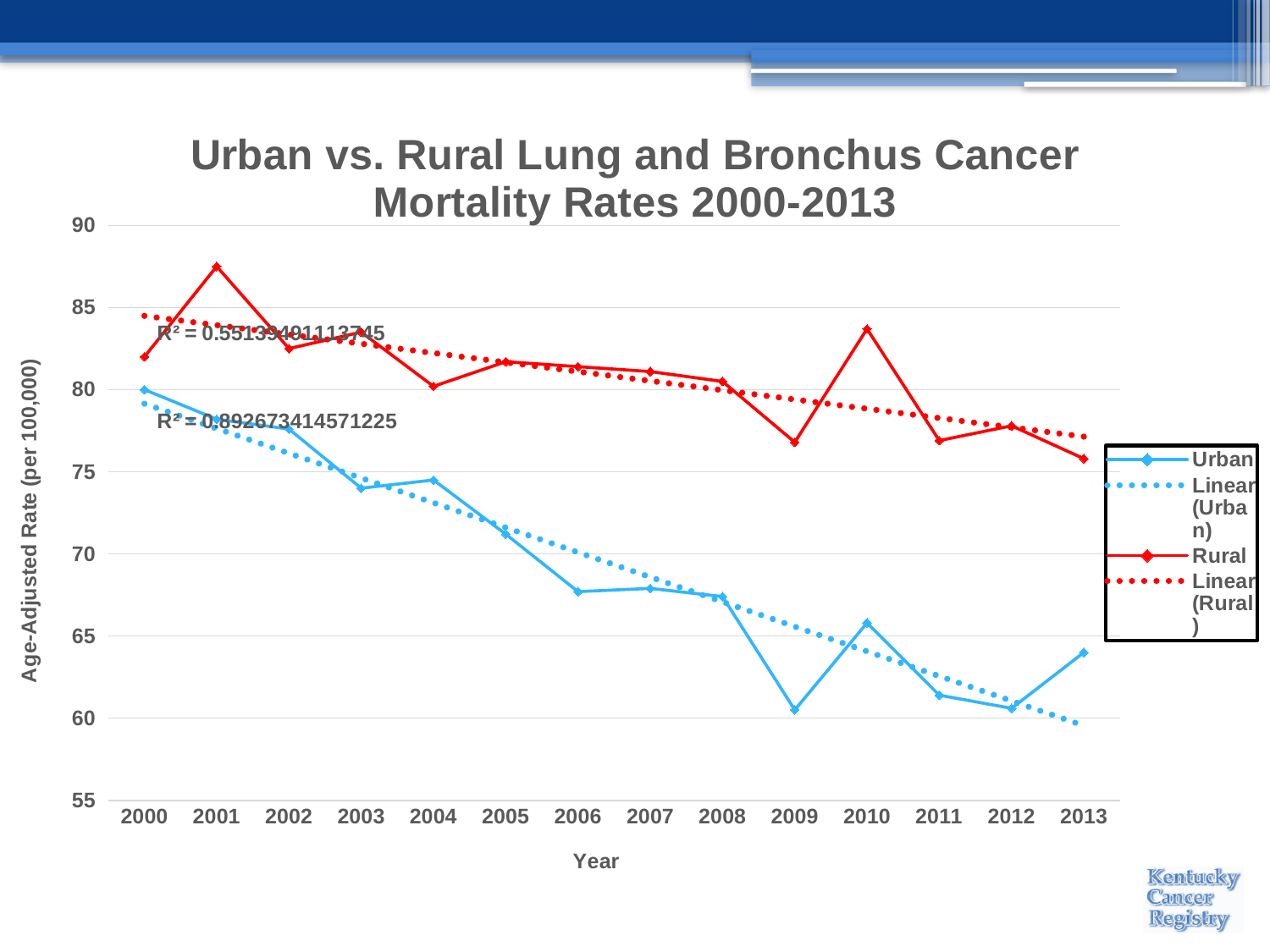
What is the title of the chart? Urban vs. Rural Lung and Bronchus Cancer Mortality Rates 2000-2013 Is the Rural value for 2001 greater or less than 85? greater How many years are plotted along the x axis? 14 Which year has the highest Urban mortality rate? 2000 How many series does the legend list? 4 Overall, does the Urban mortality rate rise or fall from 2000 to 2013? fall Which year has the lowest Urban mortality rate? 2009 Is the Rural value for 2010 greater or less than 80? greater Is the Urban value for 2009 greater or less than 65? less Which year has the highest Rural mortality rate? 2001 In 2005, which series has the larger value, Urban or Rural? Rural What kind of chart is shown on the slide? line chart